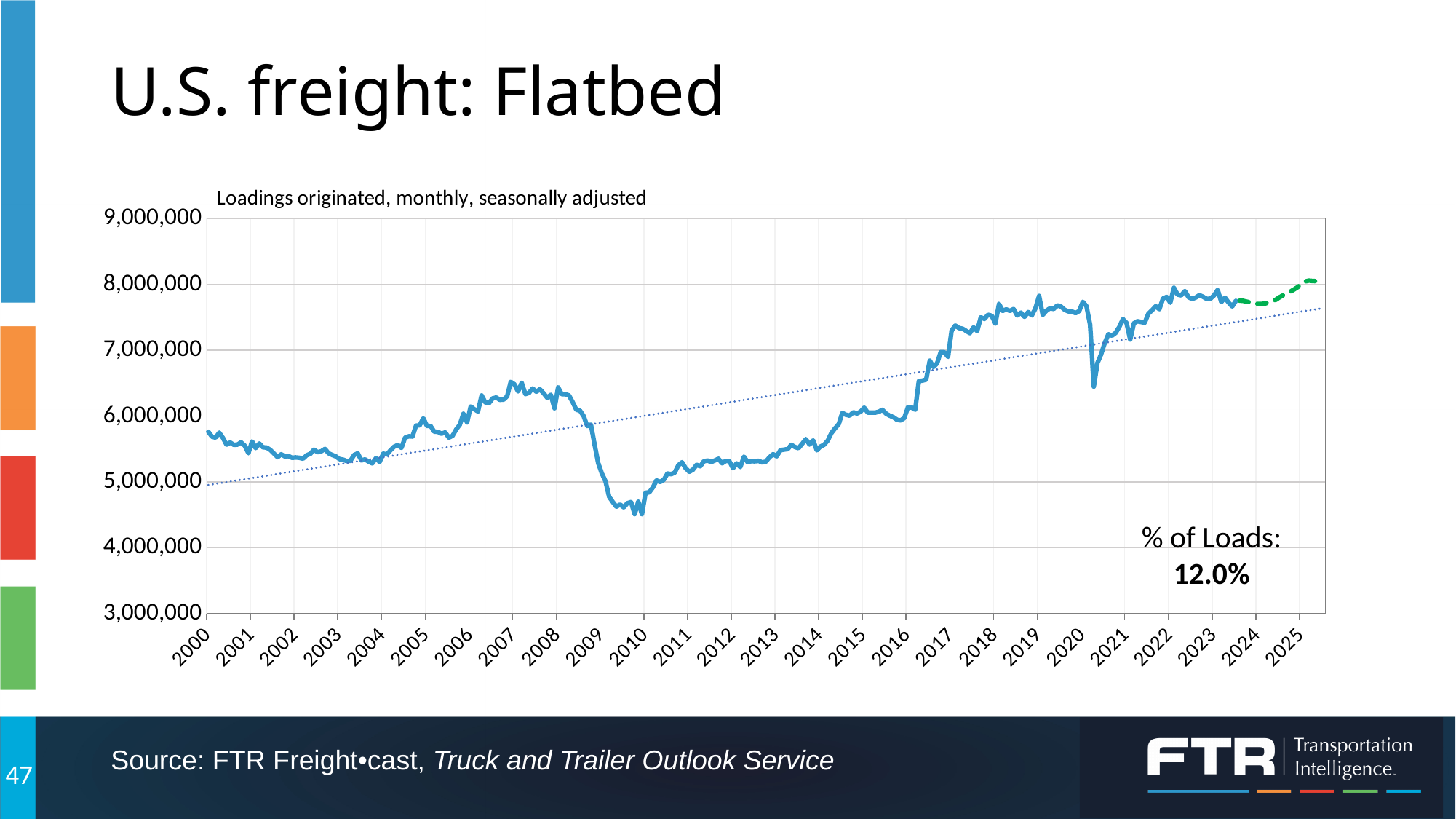
What percentage of loads is shown in the text on the chart? 12.0% What does the chart subtitle say is being plotted? Loadings originated, monthly, seasonally adjusted Which is larger, the value at the start of 2018 or the value at the start of 2012? 2018 Is the value at the start of 2007 greater or less than 6,000,000? greater Is the value at the start of 2013 greater or less than 6,000,000? less Does the dashed forecast line at the right end of the chart rise or fall toward 2025? rise What kind of chart is shown on the slide? line chart How many year labels are shown on the x axis? 26 Is the value at the start of 2010 greater or less than 5,000,000? less What is the highest value labelled on the y axis? 9,000,000 What is the title of the slide containing the chart? U.S. freight: Flatbed